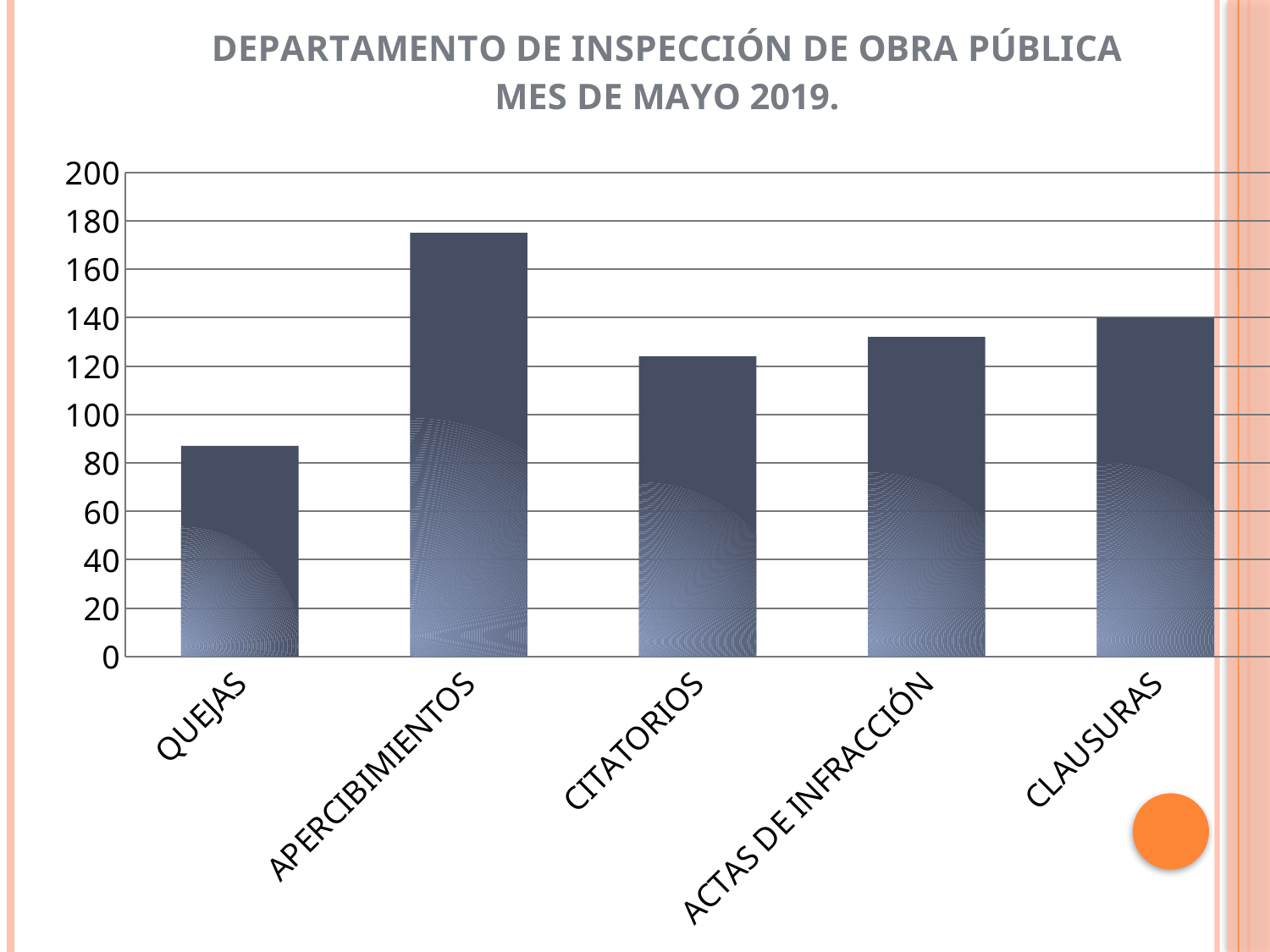
Which is larger, the value for QUEJAS or the value for CLAUSURAS? CLAUSURAS Is the value for ACTAS DE INFRACCIÓN greater or less than 160? less Is the value for QUEJAS greater or less than 100? less Is the value for APERCIBIMIENTOS greater or less than 160? greater Which is larger, the value for APERCIBIMIENTOS or the value for CITATORIOS? APERCIBIMIENTOS What kind of chart is shown on the slide? bar chart Which category has the lowest value? QUEJAS How many categories are shown on the x axis? 5 What is the title of the chart? DEPARTAMENTO DE INSPECCIÓN DE OBRA PÚBLICA MES DE MAYO 2019. Which category has the highest value? APERCIBIMIENTOS